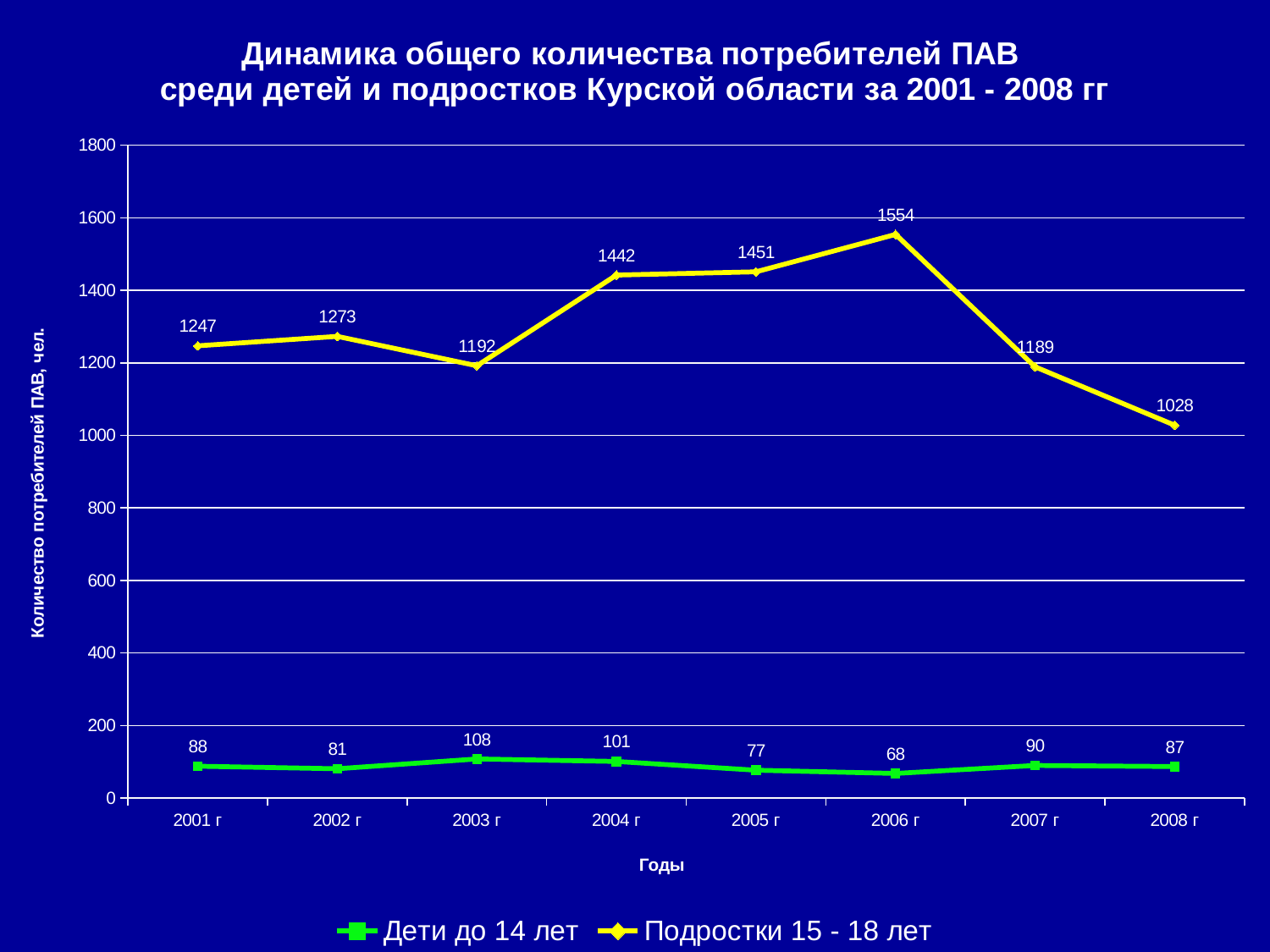
In which year is the value for Подростки 15 - 18 лет highest? 2006 г How many series does the legend list? 2 What kind of chart is this? line chart What is the difference between the Дети до 14 лет values for 2003 г and 2006 г? 40 What is the value for Подростки 15 - 18 лет in 2008 г? 1028 Which is larger for Подростки 15 - 18 лет: the value in 2002 г or in 2003 г? 2002 г What is the value for Дети до 14 лет in 2003 г? 108 How many years are shown on the x axis? 8 Does the Подростки 15 - 18 лет series rise or fall from 2006 г to 2008 г? fall What is the value for Подростки 15 - 18 лет in 2006 г? 1554 What is the difference between the Подростки 15 - 18 лет values for 2006 г and 2008 г? 526 In which year is the value for Дети до 14 лет lowest? 2006 г